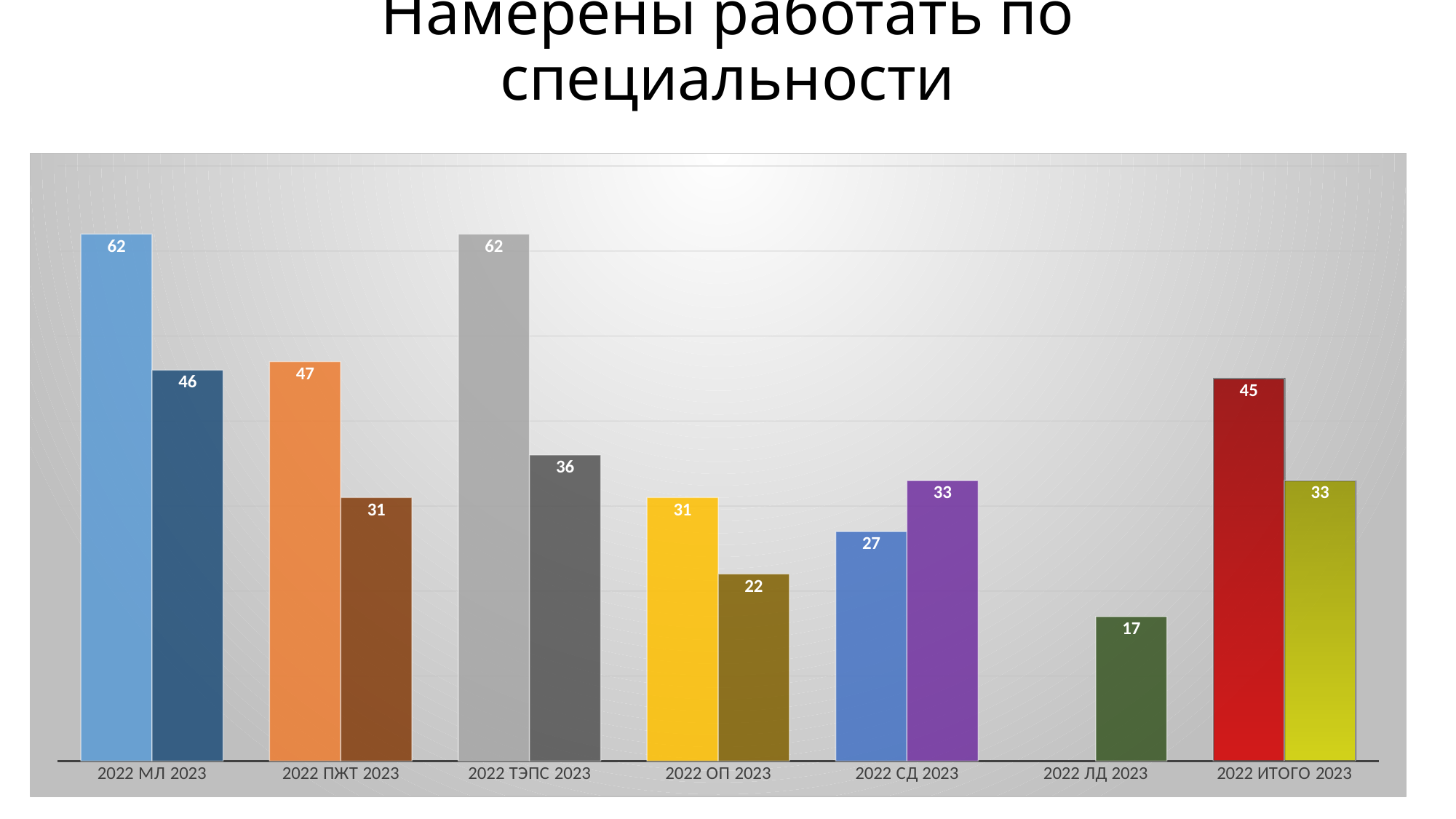
Which is larger: the 2022 value for ОП or the 2023 value for ОП? 2022 What is the difference between the 2022 and 2023 values for ТЭПС? 26 What is the 2022 value for ИТОГО? 45 What is the 2023 value for ЛД? 17 What is the difference between the 2022 and 2023 values for ИТОГО? 12 What is the title of the chart on the slide? Намерены работать по специальности What is the 2023 value for ТЭПС? 36 Which is larger for СД: the 2022 value or the 2023 value? 2023 What type of chart is shown on the slide? Bar chart Which category has the lowest value shown on the chart? ЛД What is the 2022 value for МЛ? 62 What is the 2023 value for ПЖТ? 31